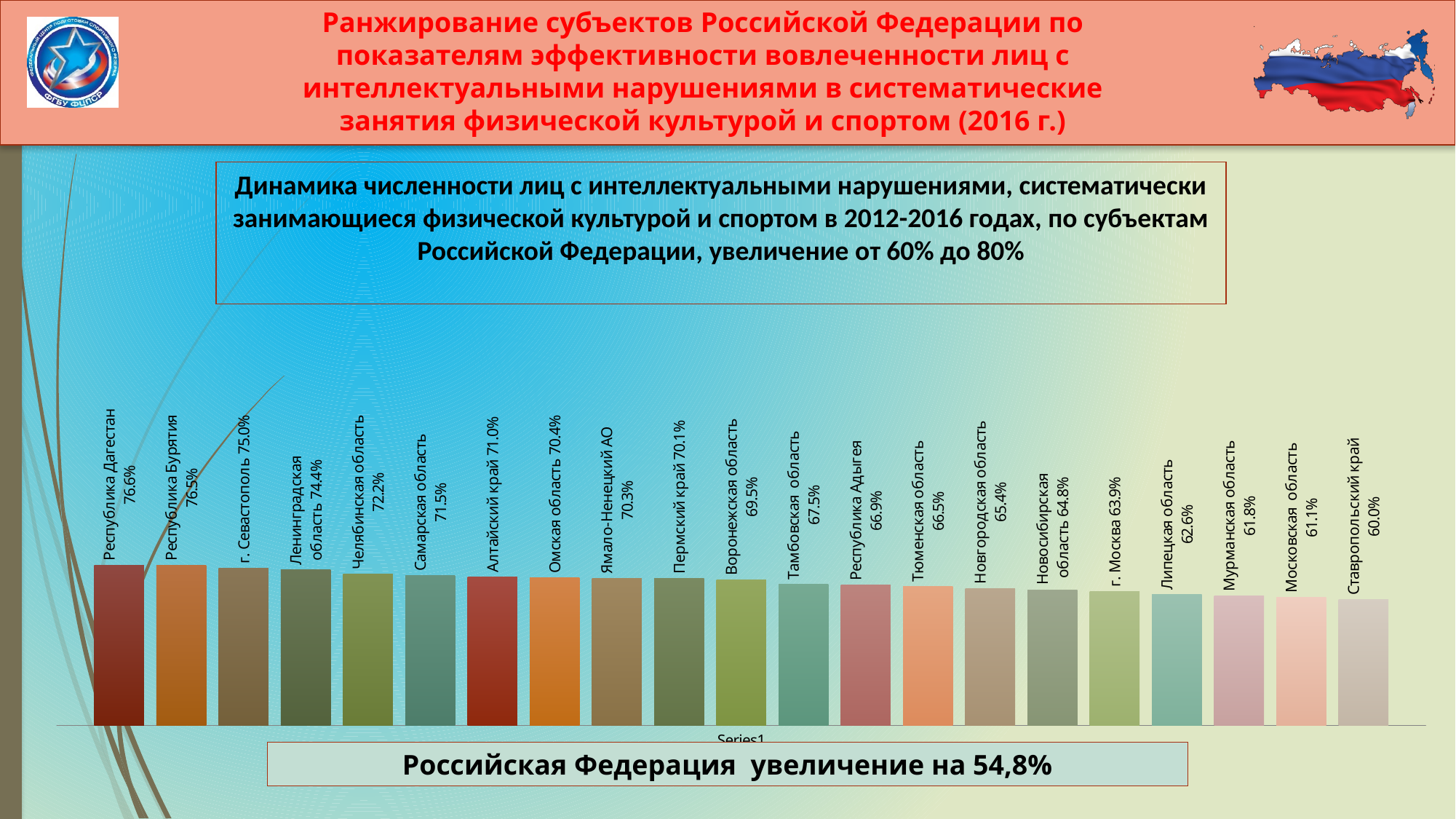
What is the value for Пермский край? 70.1% What increase for the Российская Федерация as a whole is stated below the chart? 54,8% What is the difference between the values for Республика Дагестан and Ставропольский край? 16.6 percentage points Which region has the highest value in the chart? Республика Дагестан What type of chart is shown on the slide? bar chart Which is larger, the value for Челябинская область or the value for Самарская область? Челябинская область Which region has the lowest value in the chart? Ставропольский край What is the value for Тамбовская область? 67.5% How many regions (bars) are shown in the chart? 21 What is the value for Республика Дагестан? 76.6% Do the values rise or fall from left to right across the chart? fall What is the value for г. Москва? 63.9%